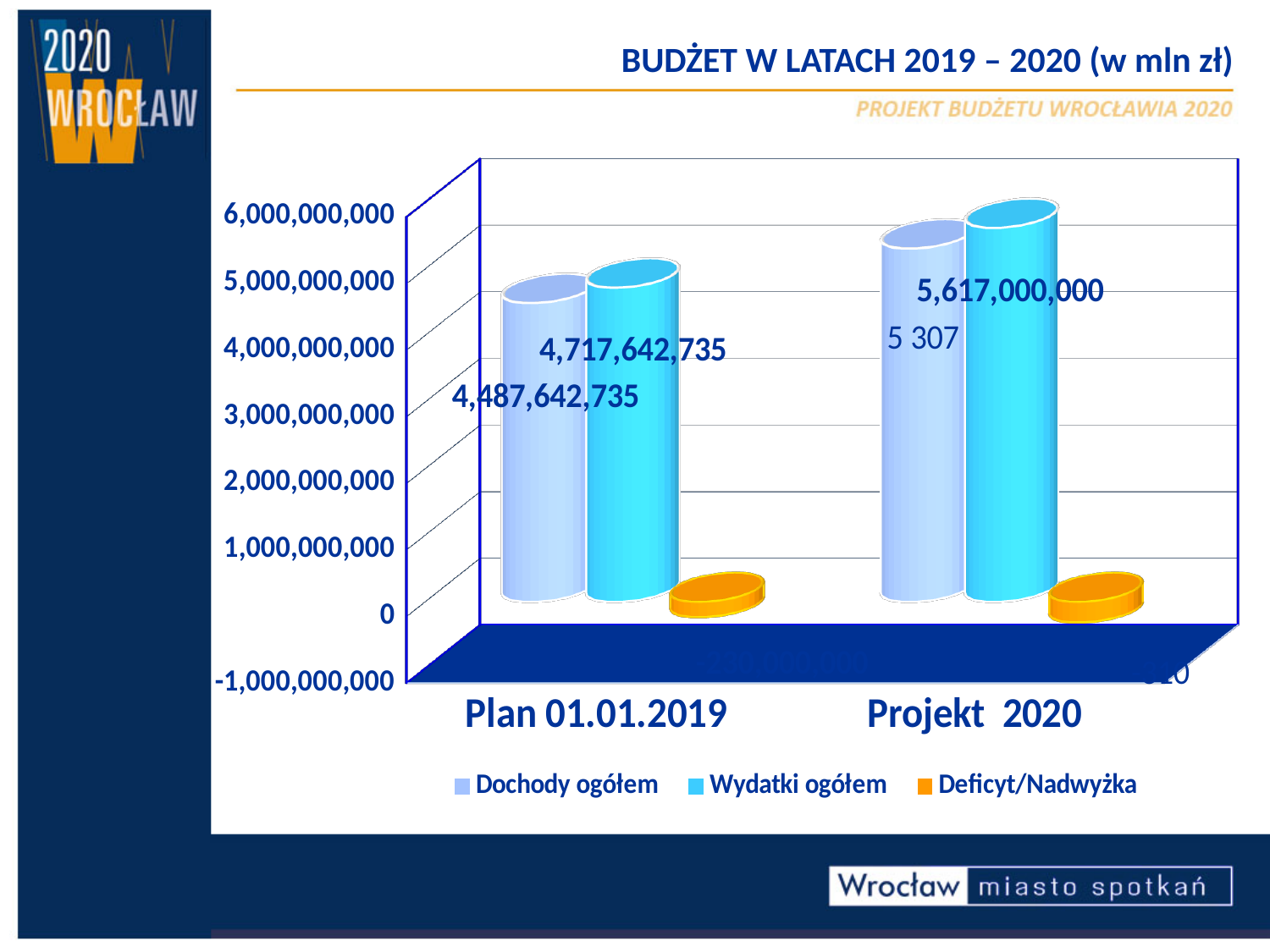
Is the value of Dochody ogółem for Projekt 2020 greater or less than 5,000,000,000? greater What is the difference between Wydatki ogółem and Dochody ogółem for Plan 01.01.2019? 230,000,000 What is the value of Dochody ogółem for Plan 01.01.2019? 4,487,642,735 What is the value of Wydatki ogółem for Plan 01.01.2019? 4,717,642,735 What kind of chart is shown on the slide? bar chart Which category has the higher Wydatki ogółem value? Projekt 2020 What is the value of Wydatki ogółem for Projekt 2020? 5,617,000,000 How many categories are shown on the x axis? 2 How many series does the legend list? 3 By how much does Wydatki ogółem for Projekt 2020 exceed Wydatki ogółem for Plan 01.01.2019? 899,357,265 Which is larger for Plan 01.01.2019: Dochody ogółem or Wydatki ogółem? Wydatki ogółem Is the value of Deficyt/Nadwyżka for Plan 01.01.2019 greater or less than 0? less